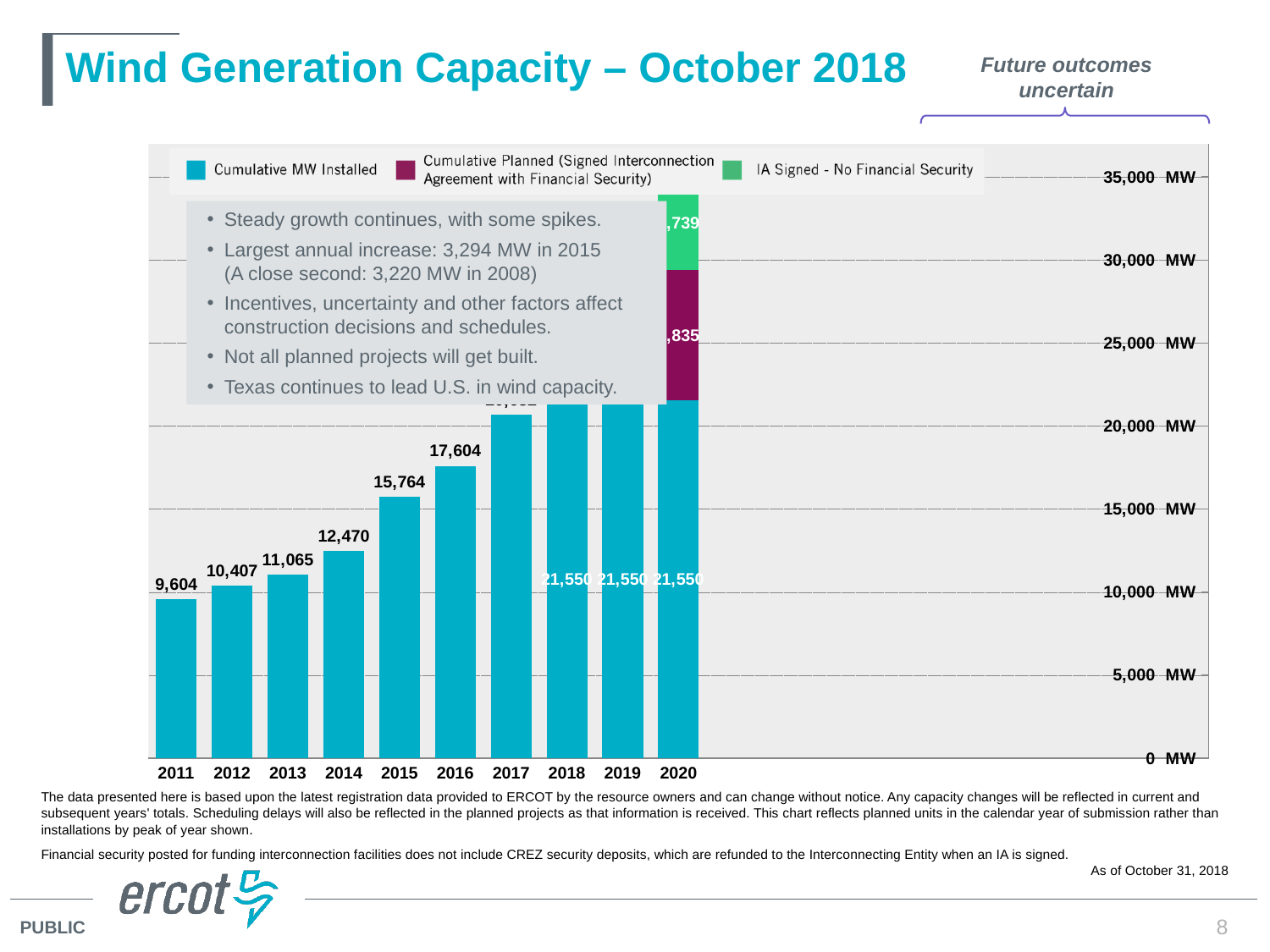
Do the Cumulative MW Installed values rise or fall from 2011 to 2016? rise How many years are shown on the x axis of the chart? 10 Which year has the lowest Cumulative MW Installed value? 2011 What is the difference between the Cumulative MW Installed values for 2012 and 2011? 803 Which year has the larger Cumulative MW Installed value, 2013 or 2014? 2014 Is the total height of the 2020 bar greater or less than 30,000 MW? greater What is the Cumulative MW Installed value for 2015? 15,764 What is the difference between the Cumulative MW Installed values for 2016 and 2015? 1,840 What is the Cumulative MW Installed value for 2011? 9,604 How many series does the chart legend list? 3 What kind of chart is shown on the slide? bar chart What is the Cumulative MW Installed value for 2018? 21,550